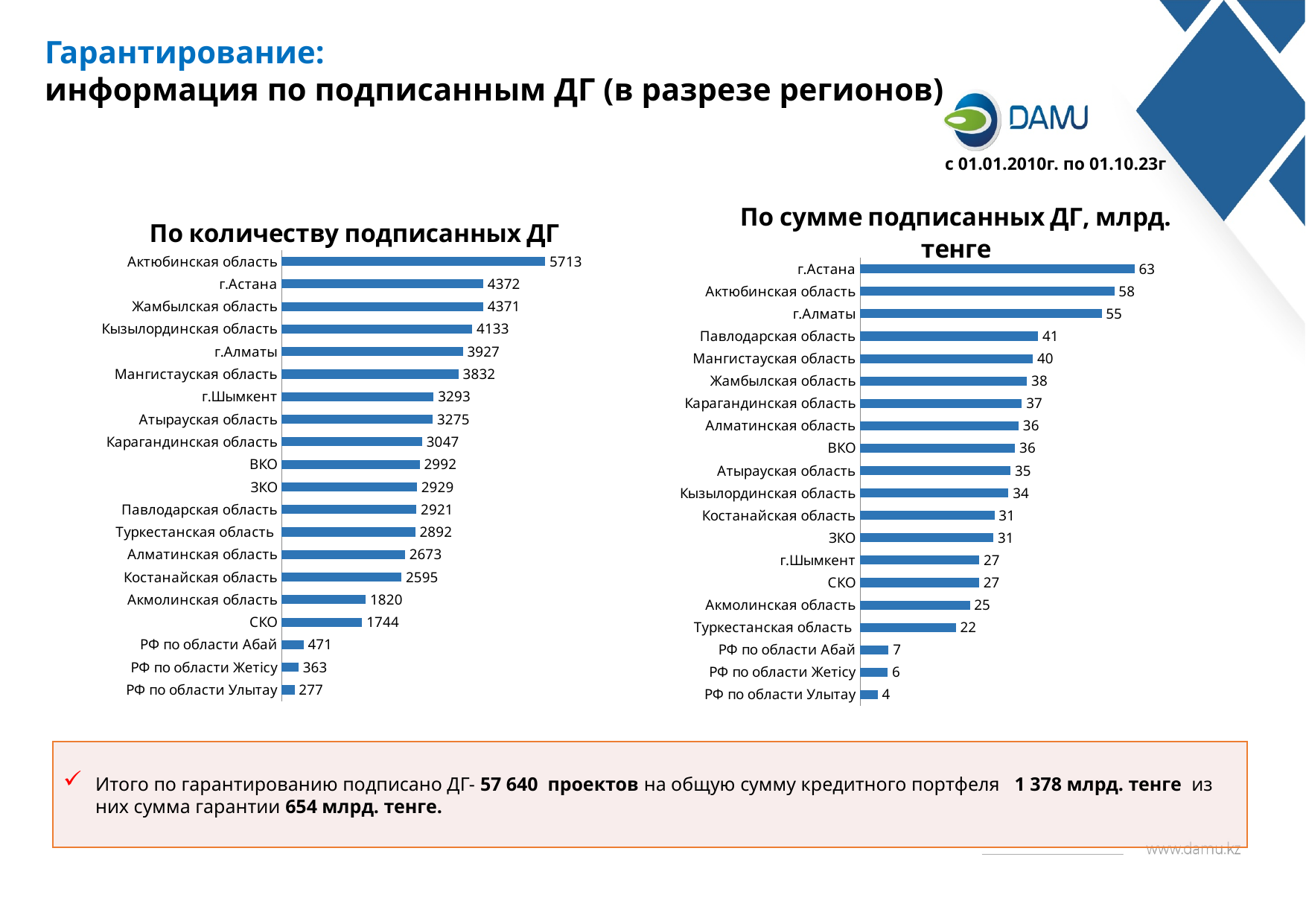
In the chart 'По сумме подписанных ДГ, млрд. тенге', which region has the highest value? г.Астана In the chart 'По сумме подписанных ДГ, млрд. тенге', what is the value for РФ по области Улытау? 4 In the chart 'По количеству подписанных ДГ', how many regions are shown? 20 In the chart 'По количеству подписанных ДГ', what is the difference between г.Астана and г.Алматы? 445 In the chart 'По количеству подписанных ДГ', which region has the lowest value? РФ по области Улытау In the chart 'По количеству подписанных ДГ', what is the value for Актюбинская область? 5713 In the chart 'По количеству подписанных ДГ', what is the value for СКО? 1744 In the chart 'По количеству подписанных ДГ', which is larger: Атырауская область or г.Шымкент? г.Шымкент What type of chart is 'По количеству подписанных ДГ'? Bar chart In the chart 'По сумме подписанных ДГ, млрд. тенге', what is the difference between г.Астана and Туркестанская область? 41 In the chart 'По сумме подписанных ДГ, млрд. тенге', which is larger: Актюбинская область or г.Алматы? Актюбинская область In the chart 'По сумме подписанных ДГ, млрд. тенге', what is the value for Павлодарская область? 41